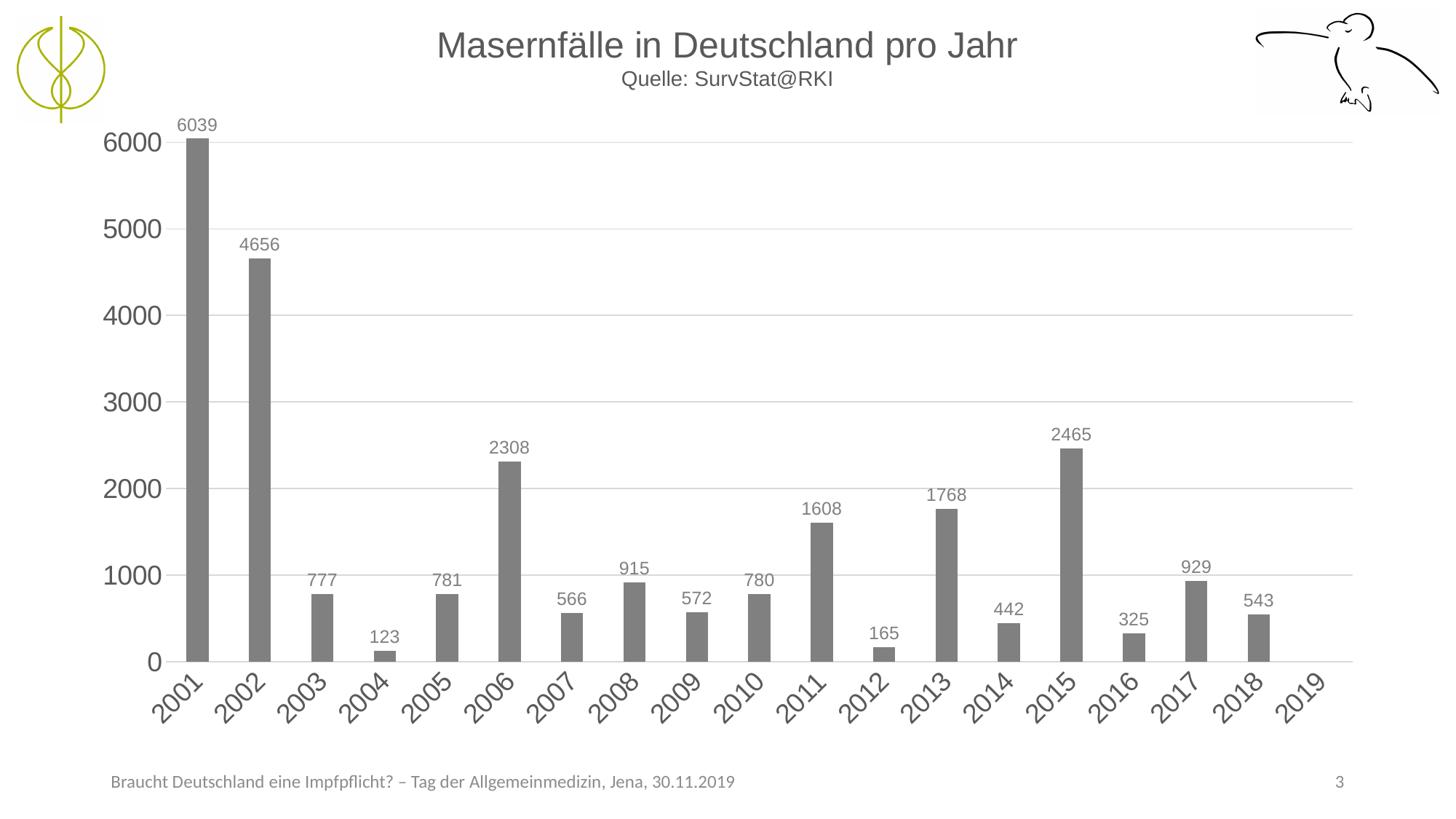
What type of chart is shown on the slide? bar chart How many measles cases are shown for 2001? 6039 What is the difference between the values for 2001 and 2002? 1383 What is the difference between the values for 2015 and 2013? 697 What is the value for 2012? 165 Which year has the larger value, 2006 or 2015? 2015 Which year has the highest number of cases? 2001 How many years are labelled on the x axis? 19 What is the value for 2015? 2465 Which year with a plotted bar has the lowest number of cases? 2004 Is the value for 2011 greater or less than 1000? greater What is the title of the chart? Masernfälle in Deutschland pro Jahr